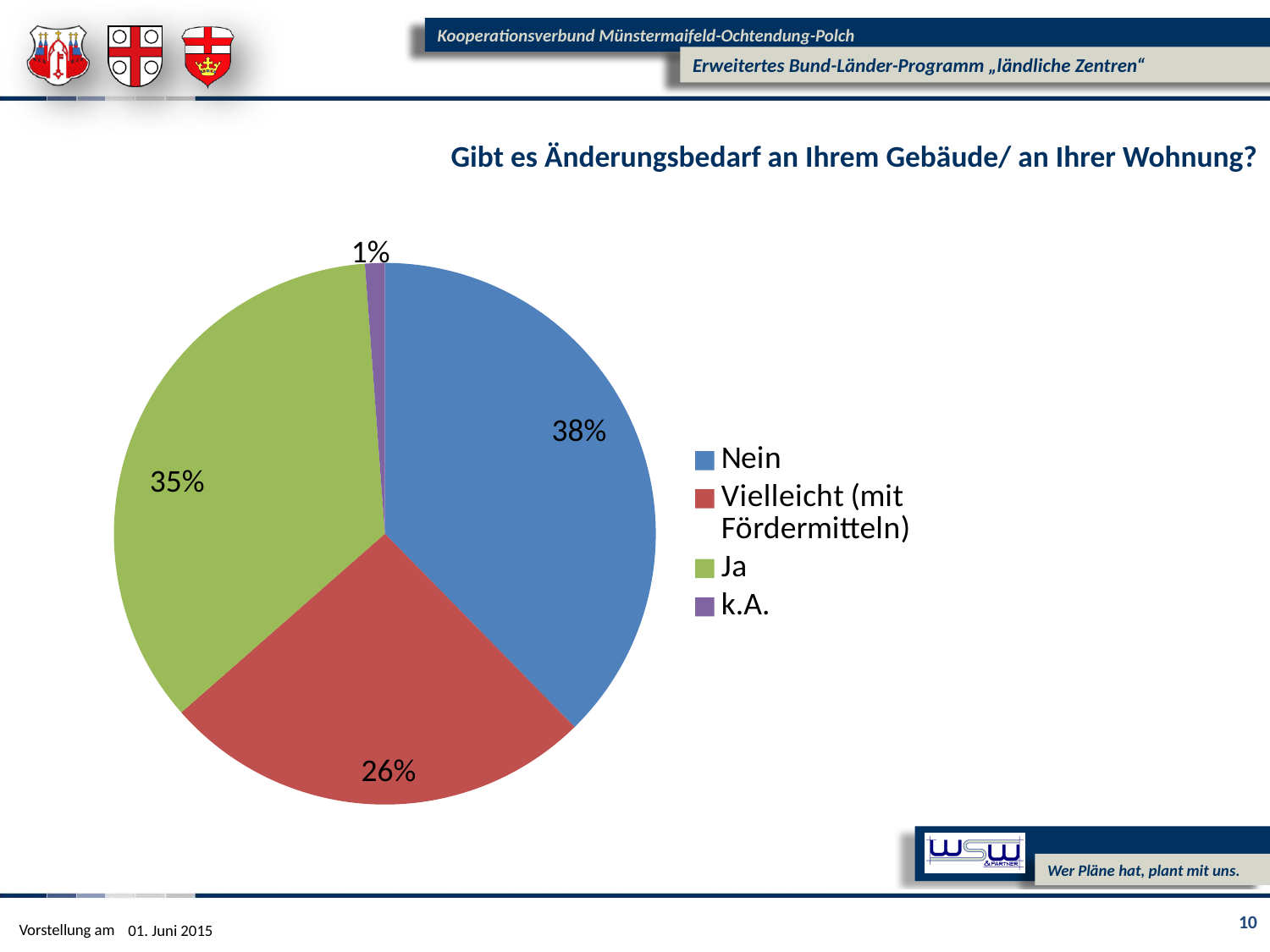
What kind of chart is shown on the slide? pie chart What colour is the slice for "Ja"? green Which category has the largest share of the pie? Nein What is the title of the chart? Gibt es Änderungsbedarf an Ihrem Gebäude/ an Ihrer Wohnung? What share of the pie does "Nein" have? 38% Which category has the smallest share of the pie? k.A. Which is larger, the share for "Ja" or the share for "Vielleicht (mit Fördermitteln)"? Ja What share of the pie does "Ja" have? 35% What is the difference in percentage points between "Nein" and "Vielleicht (mit Fördermitteln)"? 12 How many categories does the legend list? 4 What share of the pie does "Vielleicht (mit Fördermitteln)" have? 26%